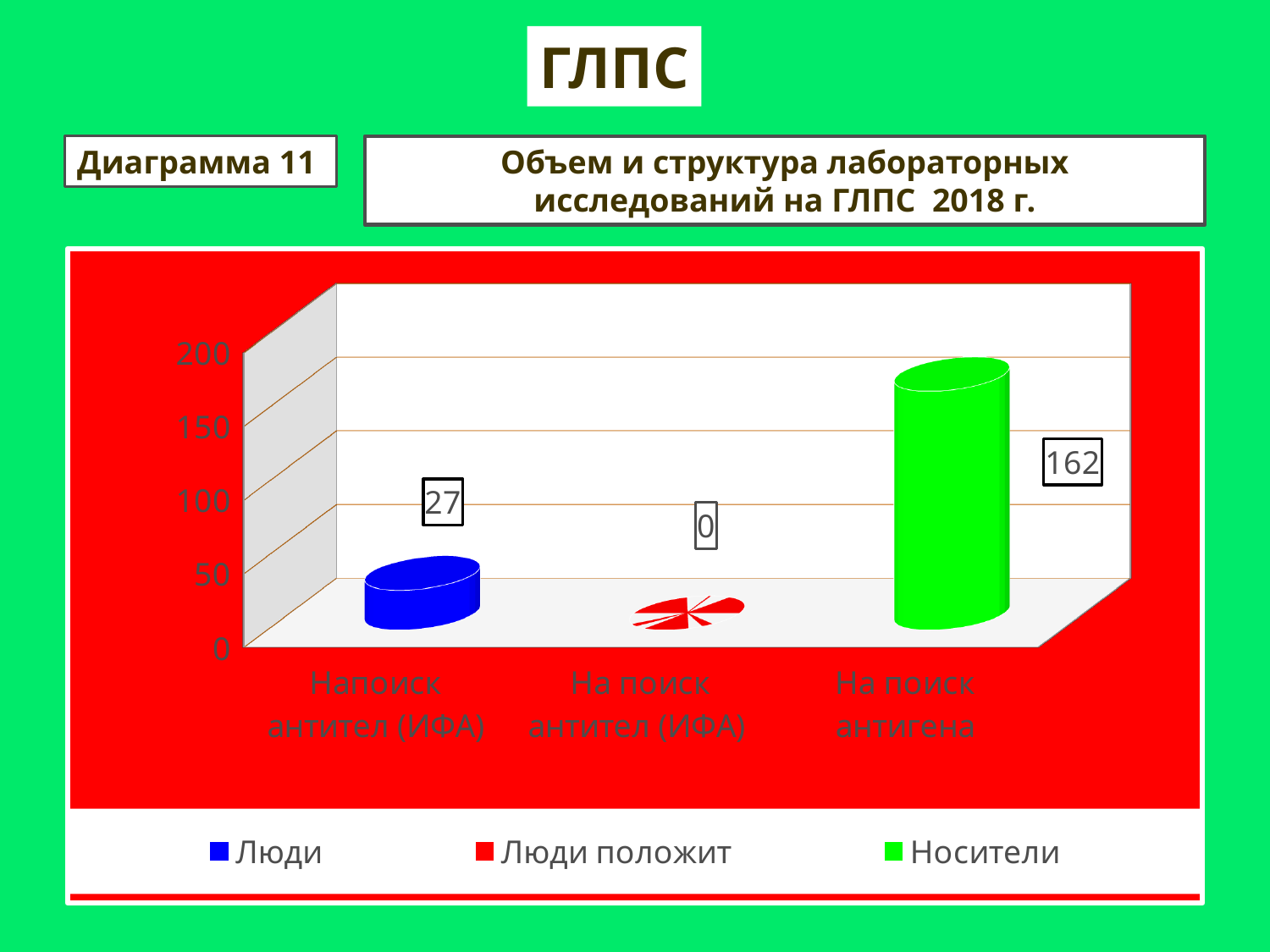
What value is shown for the Люди series? 27 Which is larger, the value for Люди or the value for Носители? Носители What value is shown for the Люди положит series? 0 What kind of chart is shown on the slide? bar chart What is the difference between the Носители value and the Люди value? 135 Is the value for Люди greater or less than 50? less What value is shown for the Носители series? 162 Is the value for Носители greater or less than 150? greater Which series has the lowest value? Люди положит How many series does the legend list? 3 Which series has the highest value? Носители What colour is the bar for the Носители series? green